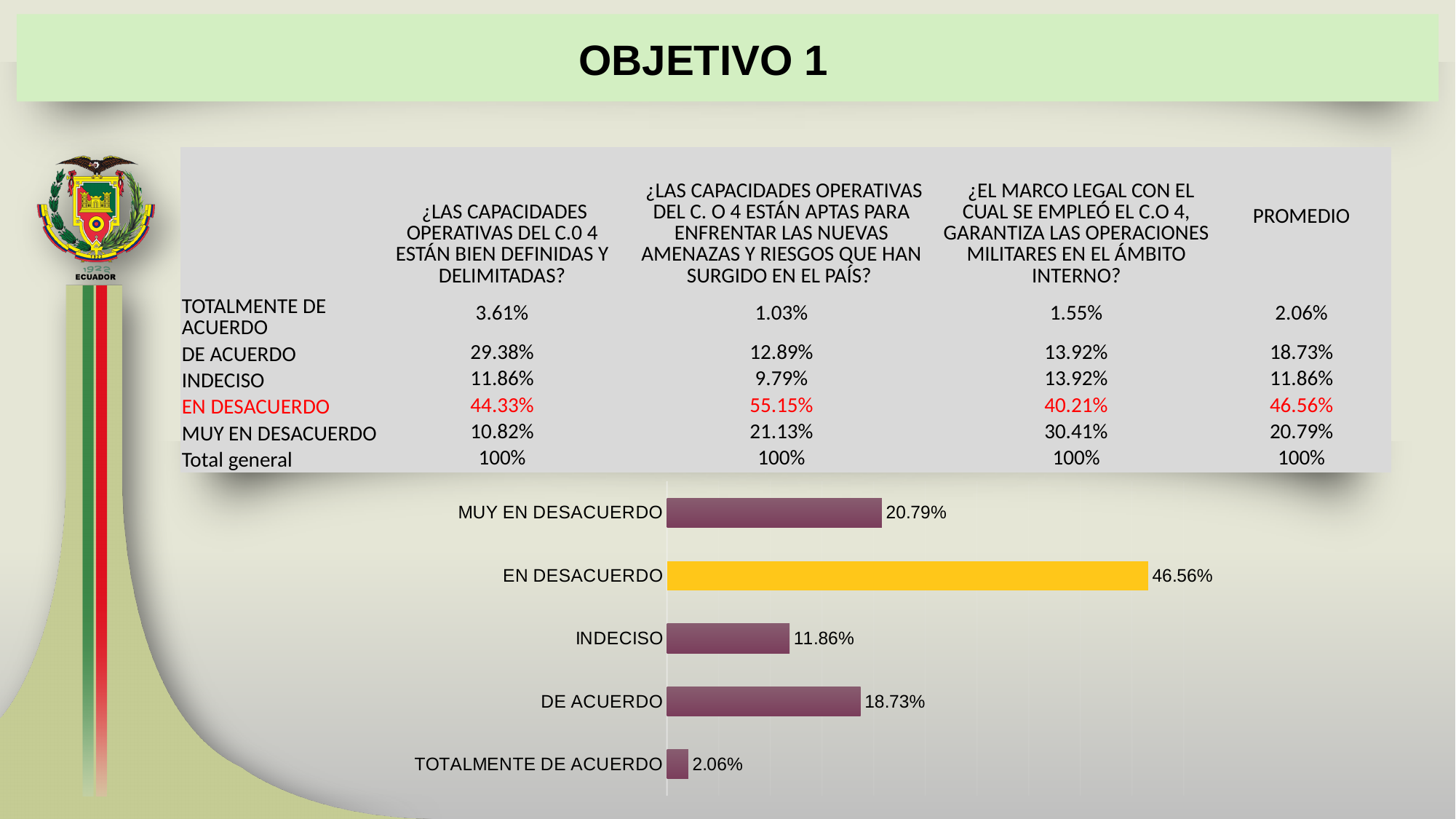
Which bar in the chart is coloured differently (yellow) from the others? EN DESACUERDO What kind of chart is shown on the slide? bar chart What is the value for DE ACUERDO in the bar chart? 18.73% Which category has the lowest value in the bar chart? TOTALMENTE DE ACUERDO What is the value for INDECISO in the bar chart? 11.86% Which is larger in the bar chart, DE ACUERDO or INDECISO? DE ACUERDO Which category has the highest value in the bar chart? EN DESACUERDO How many categories are shown in the bar chart? 5 What is the value for MUY EN DESACUERDO in the bar chart? 20.79% What is the value for TOTALMENTE DE ACUERDO in the bar chart? 2.06% What is the value for EN DESACUERDO in the bar chart? 46.56% What is the difference between the values for EN DESACUERDO and MUY EN DESACUERDO in the bar chart? 25.77%